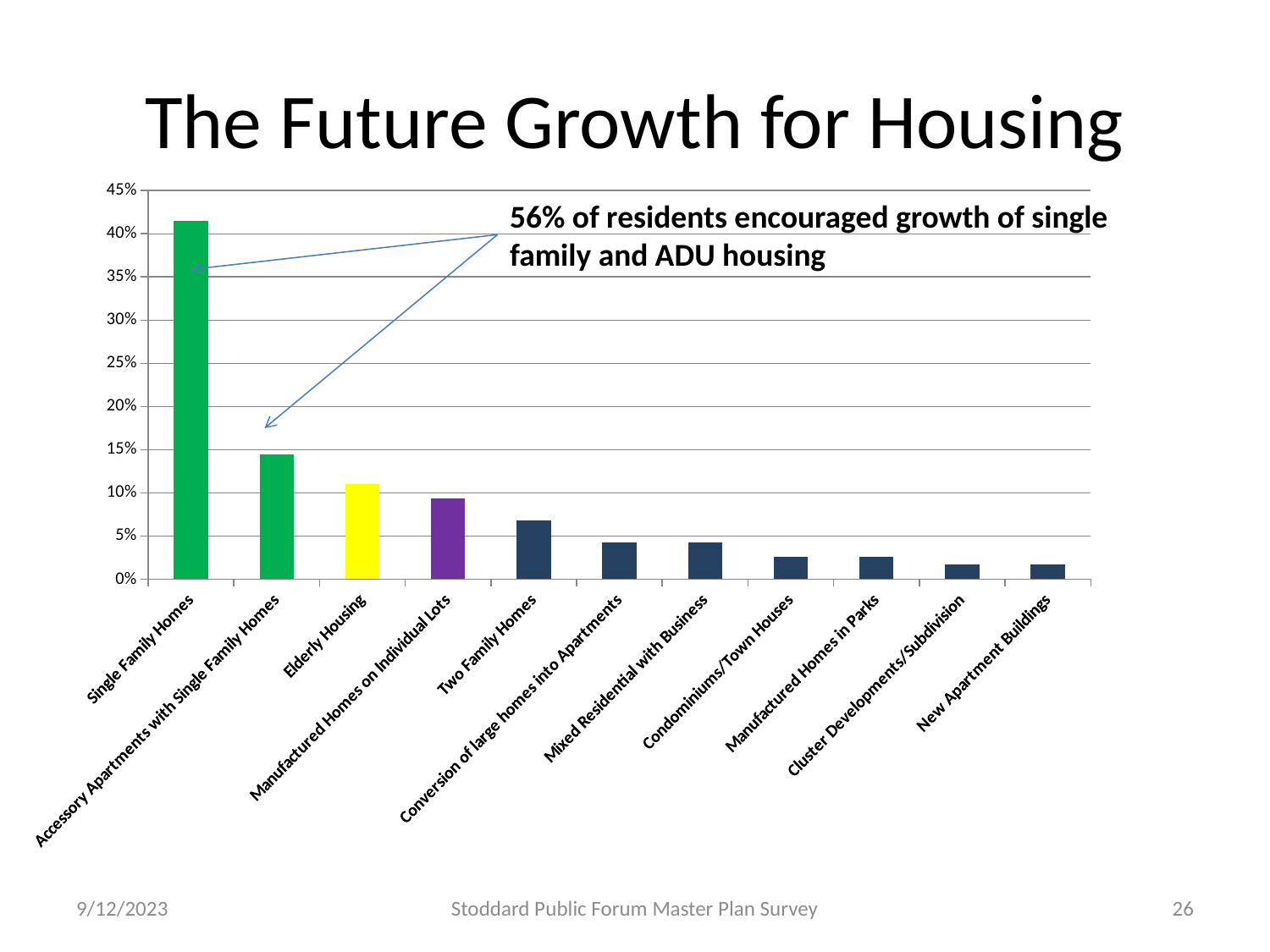
Is the value for Accessory Apartments with Single Family Homes greater or less than 15%? less How many categories are plotted on the x axis? 11 What is the title of the slide? The Future Growth for Housing Which category has the highest value? Single Family Homes Is the value for Single Family Homes greater or less than 40%? greater Do the values rise or fall moving from left to right along the x axis? fall Is the value for Two Family Homes greater or less than 10%? less What colour is the bar for Elderly Housing? yellow What kind of chart is shown on the slide? bar chart Which is larger, the value for Elderly Housing or the value for Two Family Homes? Elderly Housing